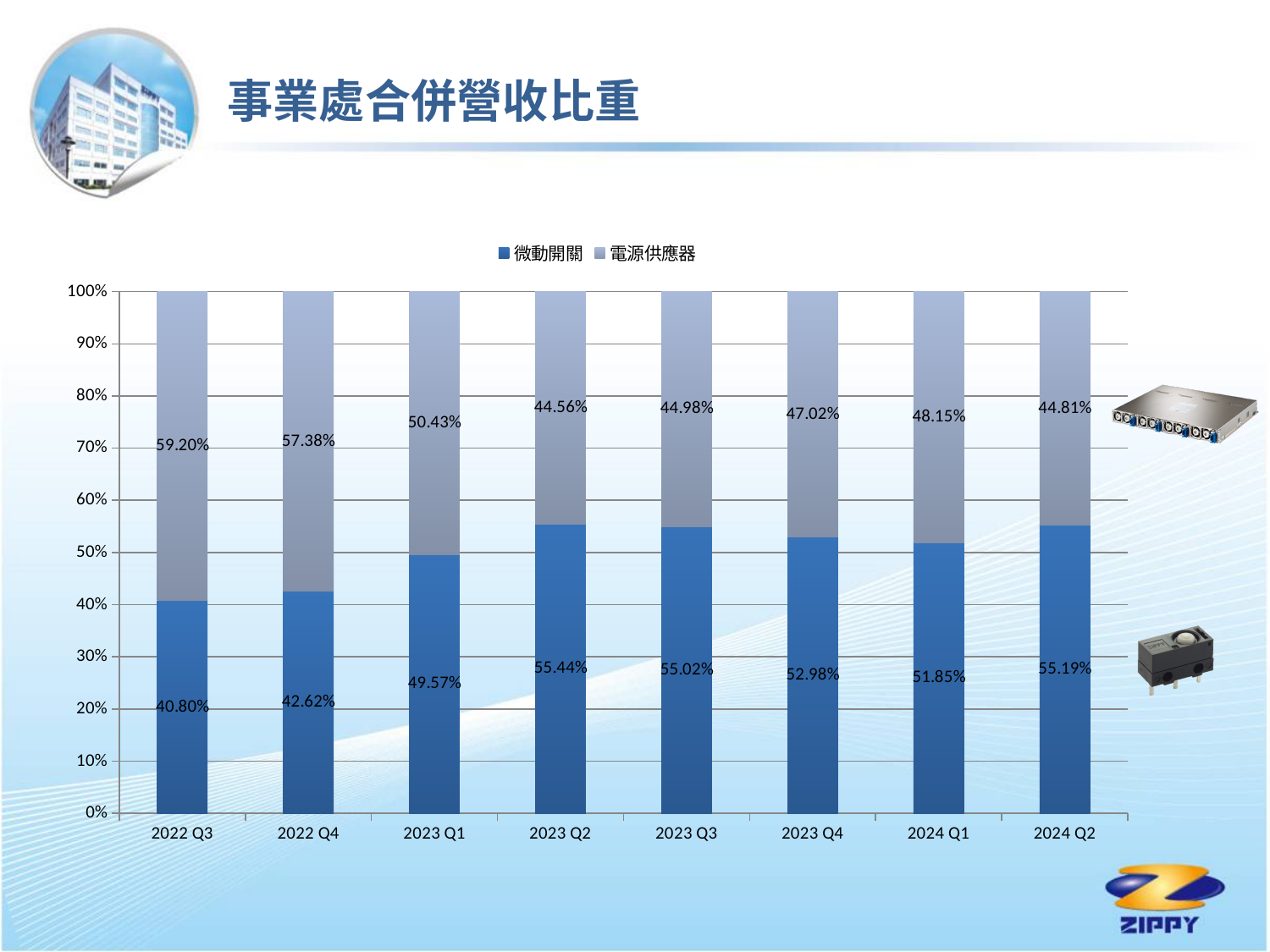
What is the value for 電源供應器 in 2024 Q1? 48.15% How many quarters are shown on the x axis? 8 Is the value for 微動開關 in 2022 Q4 greater or less than 50%? less What is the difference between the 微動開關 and 電源供應器 shares in 2024 Q2? 10.38% How many series does the legend list? 2 In which quarter is the 電源供應器 share highest? 2022 Q3 What kind of chart is shown on the slide? Stacked bar chart What is the total of the stacked bar for 2023 Q3? 100% In which quarter is the 微動開關 share lowest? 2022 Q3 What is the value for 微動開關 in 2022 Q3? 40.80% What is the value for 微動開關 in 2023 Q2? 55.44% Which is larger in 2023 Q1, the 微動開關 share or the 電源供應器 share? 電源供應器